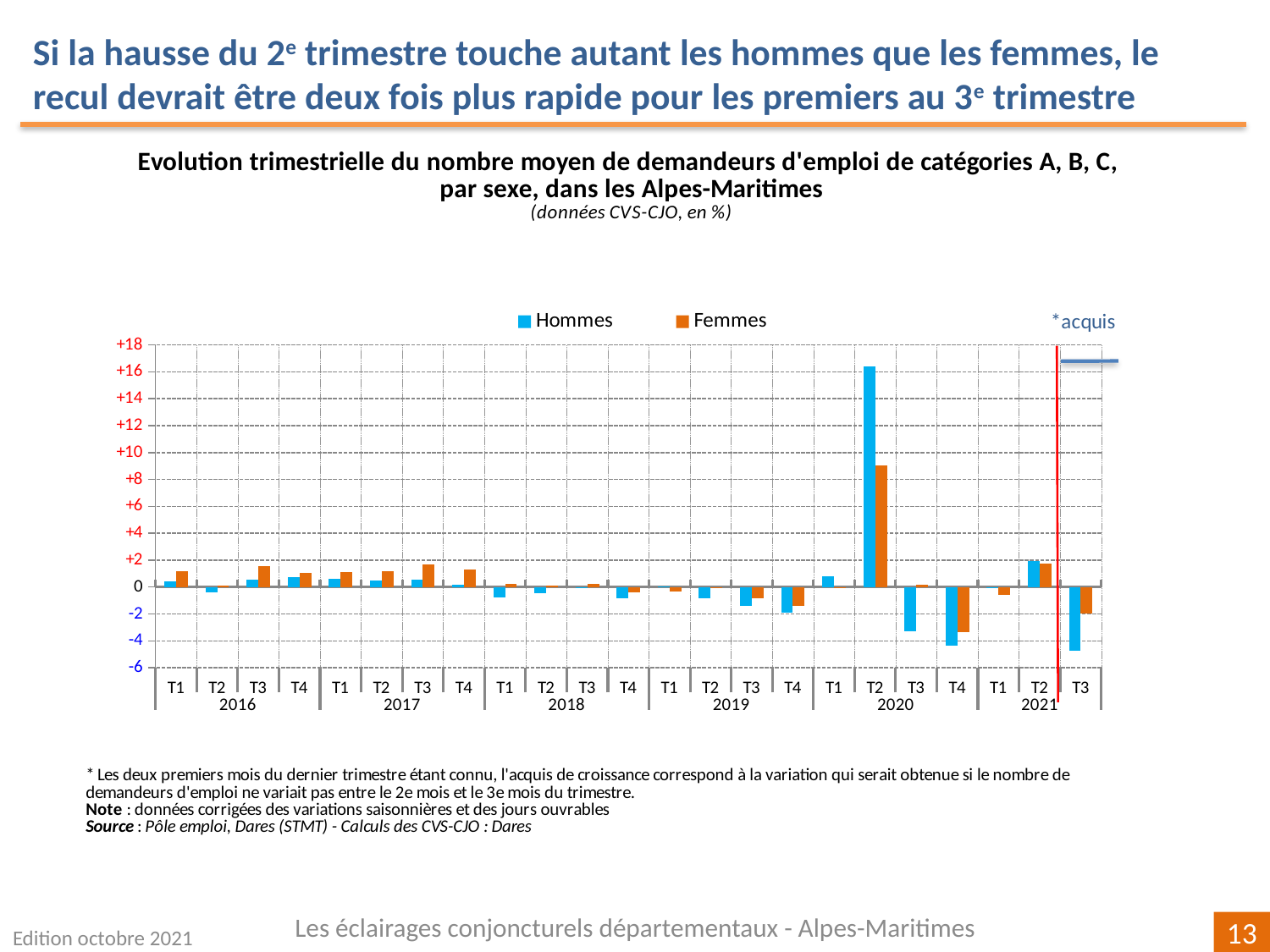
In which quarter is the value for Femmes highest? T2 2020 What kind of chart is shown on the slide? bar chart What are the two series named in the legend? Hommes and Femmes How many quarters are plotted along the x axis? 23 In T2 2020, which series has the larger value, Hommes or Femmes? Hommes In T3 2021, which series has the lower value, Hommes or Femmes? Hommes Is the value for Hommes in T2 2020 greater or less than +14? greater Is the value for Hommes in T3 2020 greater or less than -2? less Is the value for Femmes in T2 2020 greater or less than +8? greater How many series does the legend list? 2 In which quarter is the value for Femmes lowest? T4 2020 In which quarter is the value for Hommes highest? T2 2020